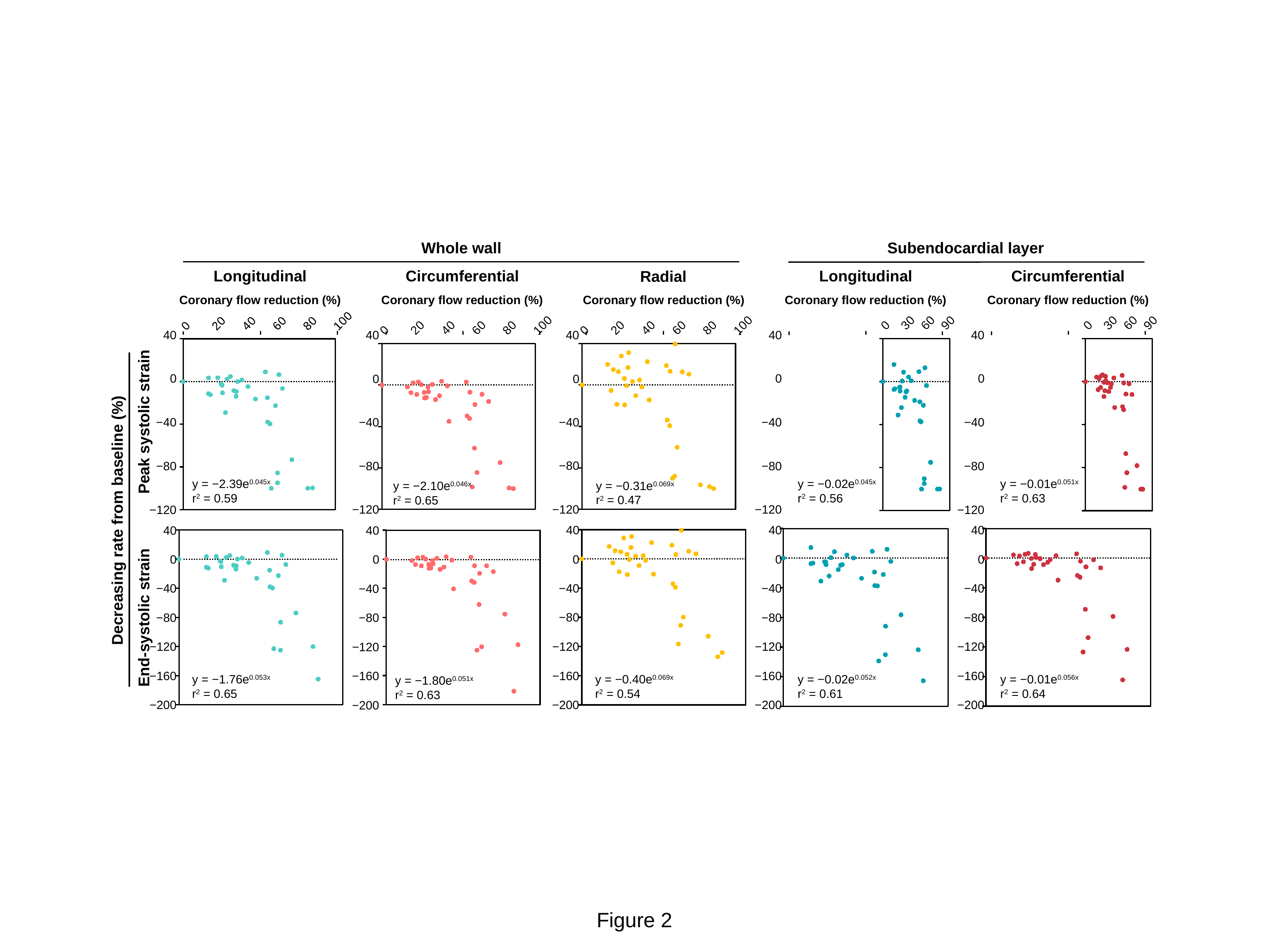
What kind of chart is the Whole wall Longitudinal Peak systolic strain chart? scatter chart What is the fitted equation printed on the Whole wall Circumferential End-systolic strain chart? y = −1.80e^0.051x What is the r² value printed on the Subendocardial layer Circumferential End-systolic strain chart? 0.64 In the Subendocardial layer Circumferential Peak systolic strain chart, is the lowest plotted value greater or less than −80? less What is the r² value printed on the Whole wall Longitudinal Peak systolic strain chart? 0.59 What is the r² value printed on the Whole wall Radial Peak systolic strain chart? 0.47 What is the x-axis label on the Whole wall Radial Peak systolic strain chart? Coronary flow reduction (%) Which chart has the higher printed r² value: Whole wall Circumferential Peak systolic strain or Whole wall Radial Peak systolic strain? Whole wall Circumferential Peak systolic strain How many charts are shown on the slide? 10 In the Whole wall Longitudinal End-systolic strain chart, is the lowest plotted value greater or less than −120? less In the Whole wall Radial End-systolic strain chart, do the strain values generally rise or fall as coronary flow reduction increases? fall What colour are the data points in the Whole wall Radial charts? yellow